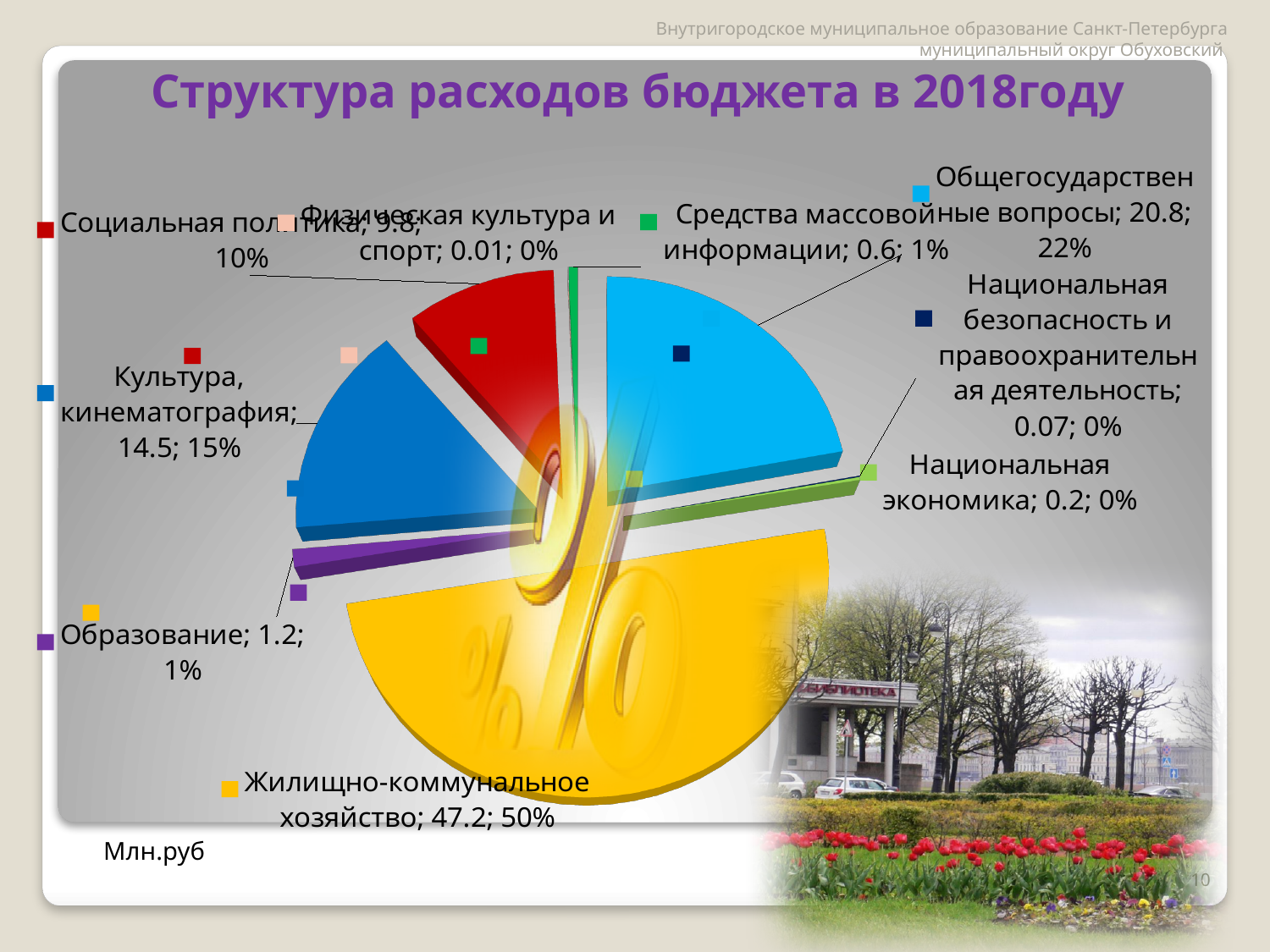
What share of the pie does Культура, кинематография take? 15% What kind of chart is shown on the slide? pie chart Which category has the smallest value? Физическая культура и спорт What share of the pie does Жилищно-коммунальное хозяйство take? 50% What unit is indicated for the values in the chart? Млн.руб What is the value for Жилищно-коммунальное хозяйство? 47.2 Which is larger, the value for Культура, кинематография or the value for Социальная политика? Культура, кинематография What is the value for Образование? 1.2 What is the difference between the values for Жилищно-коммунальное хозяйство and Общегосударственные вопросы? 26.4 What is the value for Общегосударственные вопросы? 20.8 Which category has the largest slice of the pie? Жилищно-коммунальное хозяйство How many categories does the pie chart have? 9